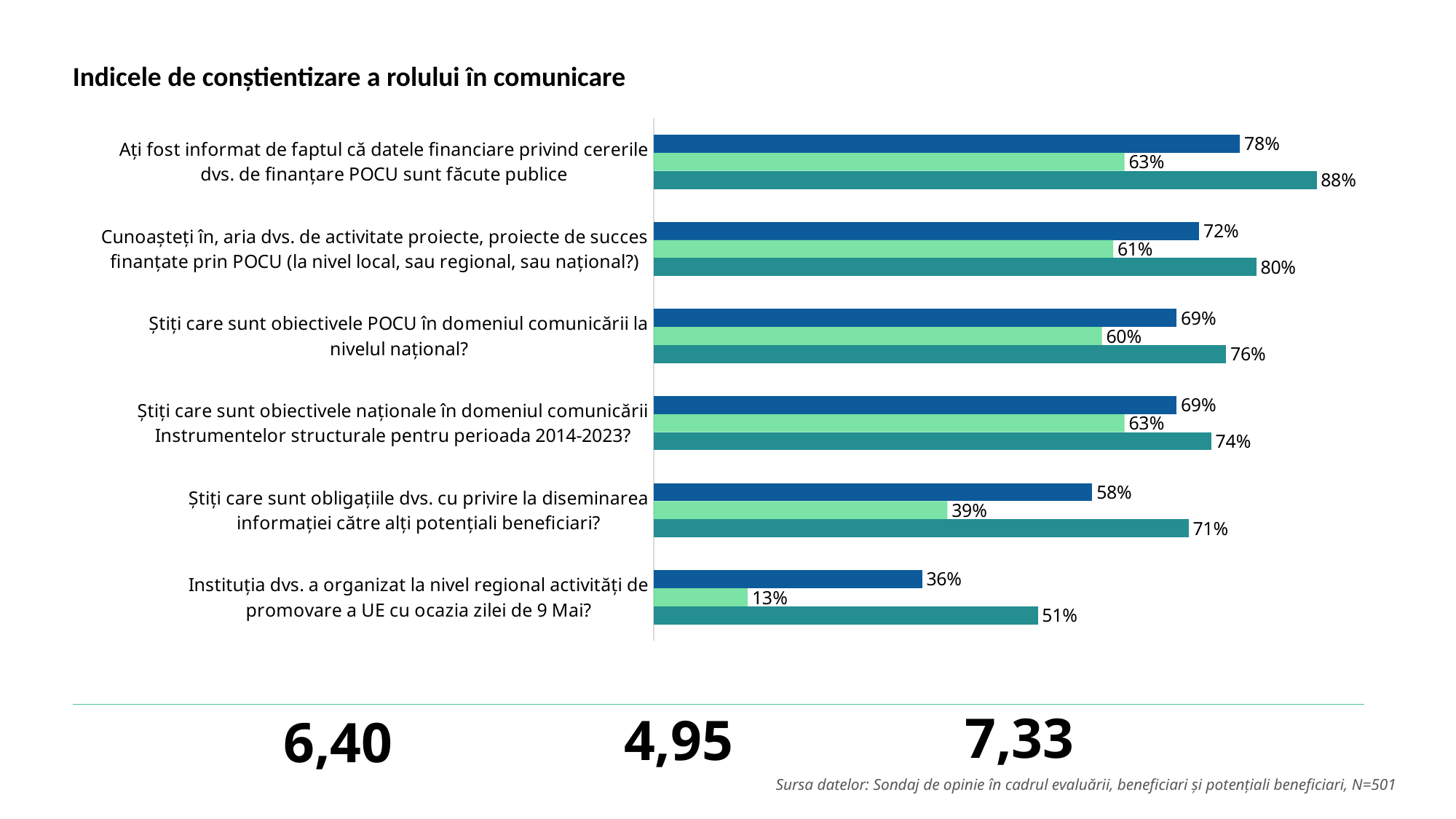
What is the value of the light green bar for "Știți care sunt obiectivele POCU în domeniul comunicării la nivelul național?"? 60% For "Cunoașteți în, aria dvs. de activitate proiecte, proiecte de succes finanțate prin POCU", which is larger: the dark blue bar or the light green bar? the dark blue bar What is the difference between the dark blue bar and the teal bar for "Știți care sunt obiectivele naționale în domeniul comunicării Instrumentelor structurale pentru perioada 2014-2023?"? 5% What is the title of the chart? Indicele de conștientizare a rolului în comunicare What is the value of the dark blue bar for "Ați fost informat de faptul că datele financiare privind cererile dvs. de finanțare POCU sunt făcute publice"? 78% Which category has the lowest dark blue bar value? Instituția dvs. a organizat la nivel regional activități de promovare a UE cu ocazia zilei de 9 Mai? What type of chart is shown on the slide? bar chart How many categories (questions) are shown on the chart? 6 Which category has the highest teal (bottom) bar value? Ați fost informat de faptul că datele financiare privind cererile dvs. de finanțare POCU sunt făcute publice What is the value of the light green bar for "Instituția dvs. a organizat la nivel regional activități de promovare a UE cu ocazia zilei de 9 Mai?"? 13% What is the value of the teal (bottom) bar for "Știți care sunt obligațiile dvs. cu privire la diseminarea informației către alți potențiali beneficiari?"? 71% What is the difference between the teal bar and the light green bar for "Știți care sunt obligațiile dvs. cu privire la diseminarea informației către alți potențiali beneficiari?"? 32%